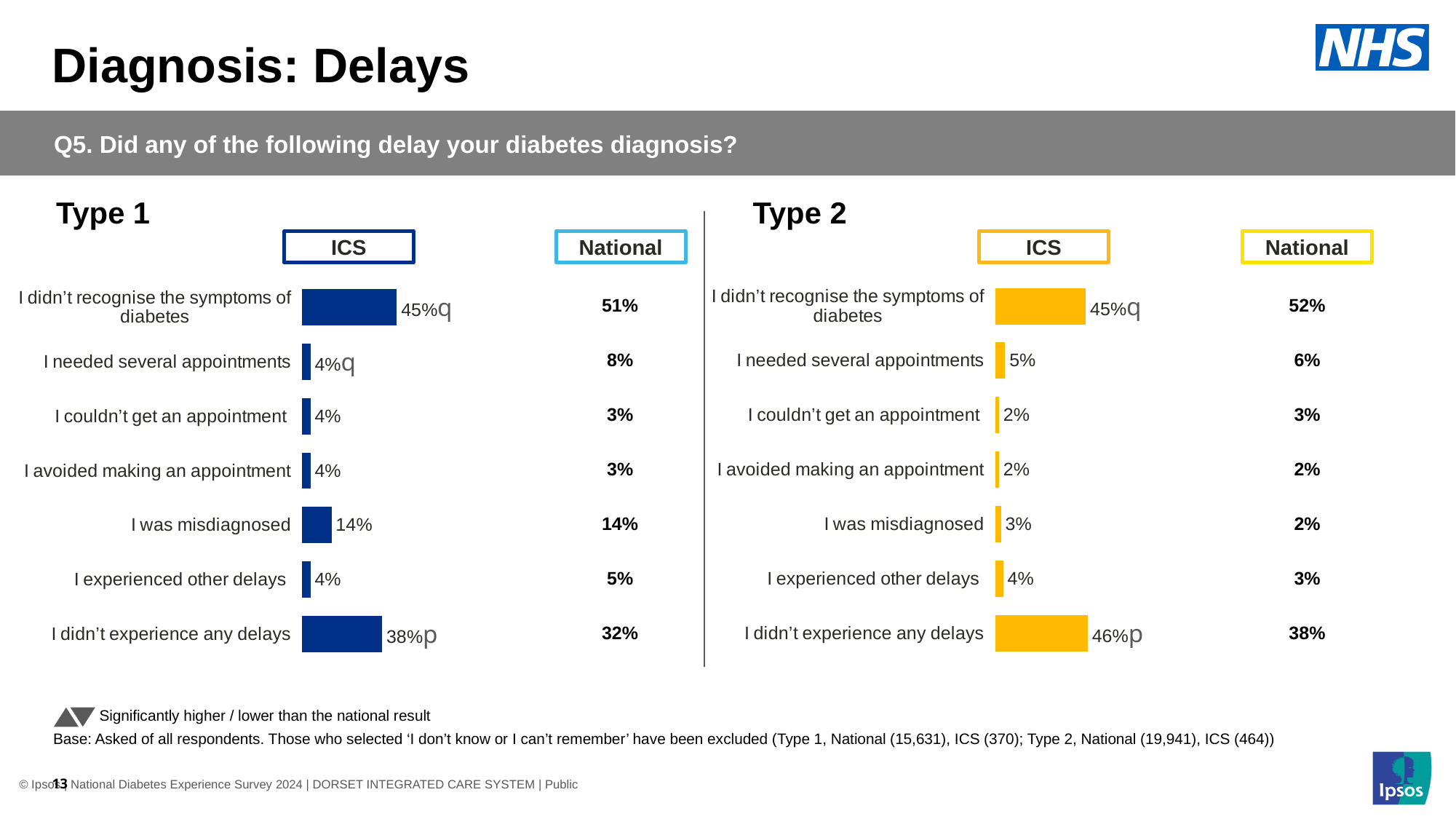
In the Type 2 chart, what is the National value for 'I was misdiagnosed'? 2% In the Type 1 chart, what is the National value for 'I didn't experience any delays'? 32% In the Type 1 chart, which is larger for 'I was misdiagnosed': the ICS value or the National value? They are equal (14%) In the Type 1 chart, what is the ICS value for 'I didn't recognise the symptoms of diabetes'? 45% In the Type 2 chart, what is the ICS value for 'I didn't experience any delays'? 46% In the Type 1 chart, what is the difference between the National and ICS values for 'I didn't recognise the symptoms of diabetes'? 6% What type of chart is used to show the ICS values in the Type 2 chart? Bar chart In the Type 2 chart, which is larger for 'I needed several appointments': the ICS value or the National value? National In the Type 2 chart, which category has the highest ICS value? I didn't experience any delays In the Type 2 chart, what is the difference between the ICS and National values for 'I didn't experience any delays'? 8% How many categories are shown in the Type 1 chart? 7 In the Type 1 chart, which category has the highest ICS value? I didn't recognise the symptoms of diabetes